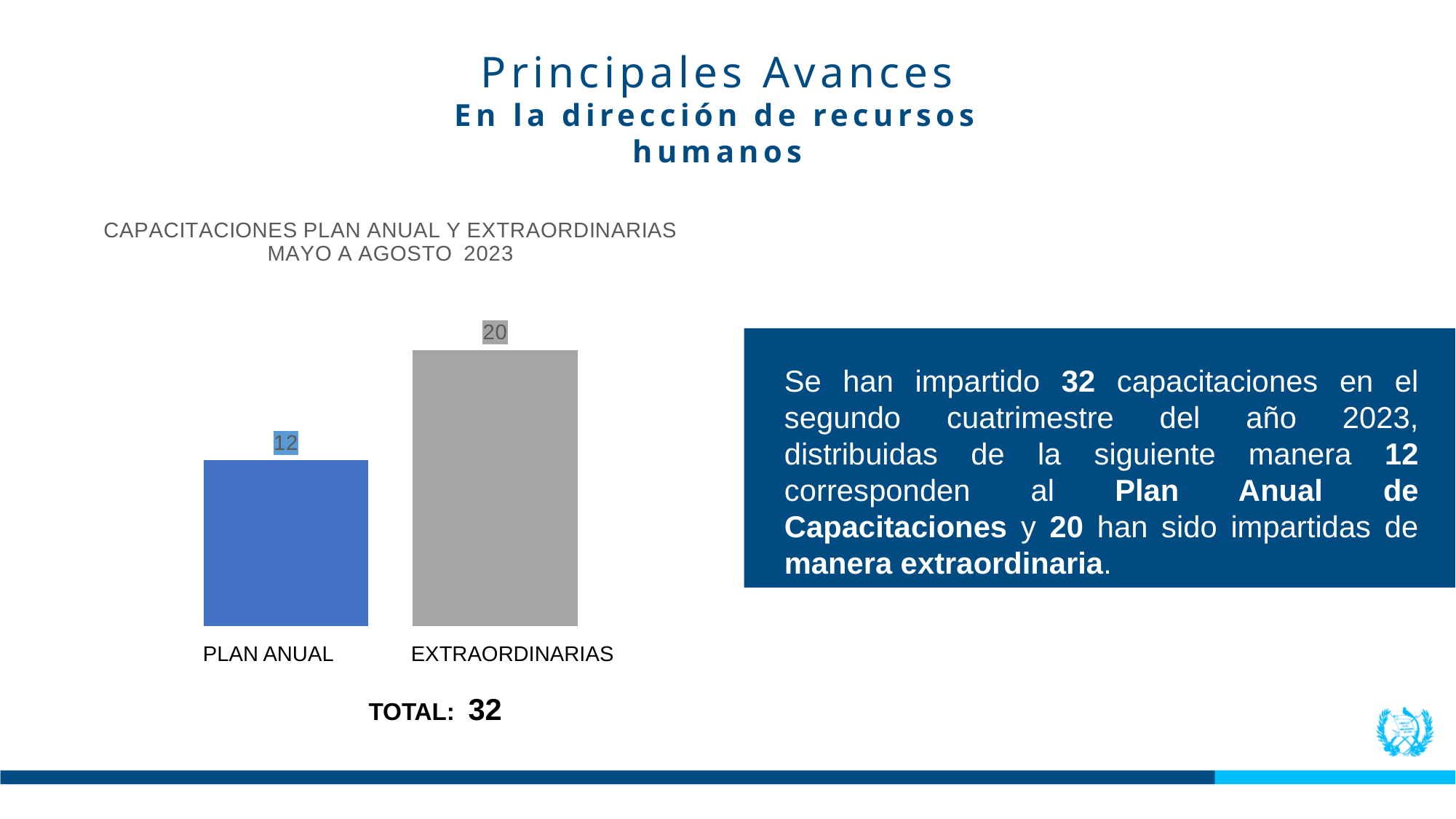
What colour is the bar for PLAN ANUAL? Blue Which is larger, the value for PLAN ANUAL or the value for EXTRAORDINARIAS? EXTRAORDINARIAS What is the difference between the values for EXTRAORDINARIAS and PLAN ANUAL? 8 Which category has the highest value? EXTRAORDINARIAS Which category has the lowest value? PLAN ANUAL What is the value for EXTRAORDINARIAS? 20 What kind of chart is shown on the slide? Bar chart What is the value for PLAN ANUAL? 12 What is the title of the chart? CAPACITACIONES PLAN ANUAL Y EXTRAORDINARIAS MAYO A AGOSTO 2023 How many categories are shown in the chart? 2 What is the total of the two bars in the chart? 32